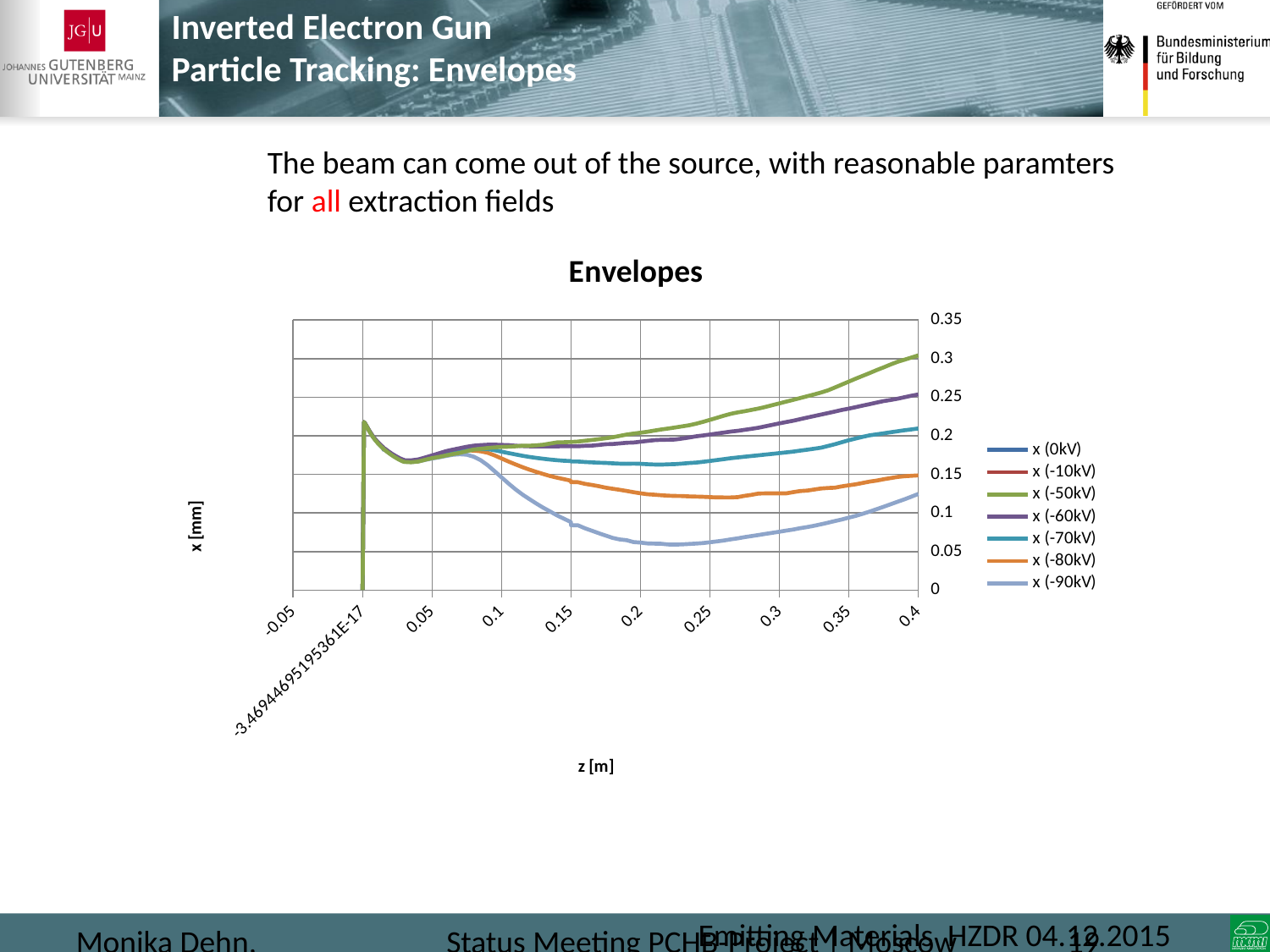
Does the x (-50kV) series rise or fall between z = 0.1 and z = 0.4? rise Is the value of the x (-90kV) series at z = 0.2 greater or less than 0.1? less Is the value of the x (-50kV) series at z = 0.4 greater or less than 0.25? greater At z = 0.4, which series has the larger value: x (-60kV) or x (-80kV)? x (-60kV) What is the title of the chart? Envelopes Does the x (-90kV) series rise or fall between z = 0.05 and z = 0.2? fall Is the value of the x (-70kV) series at z = 0.4 greater or less than 0.15? greater What is the label of the vertical axis of the Envelopes chart? x [mm] What type of chart is shown on the slide? line chart How many series does the legend of the Envelopes chart list? 7 Which series has the highest value at z = 0.4 in the Envelopes chart? x (-50kV)